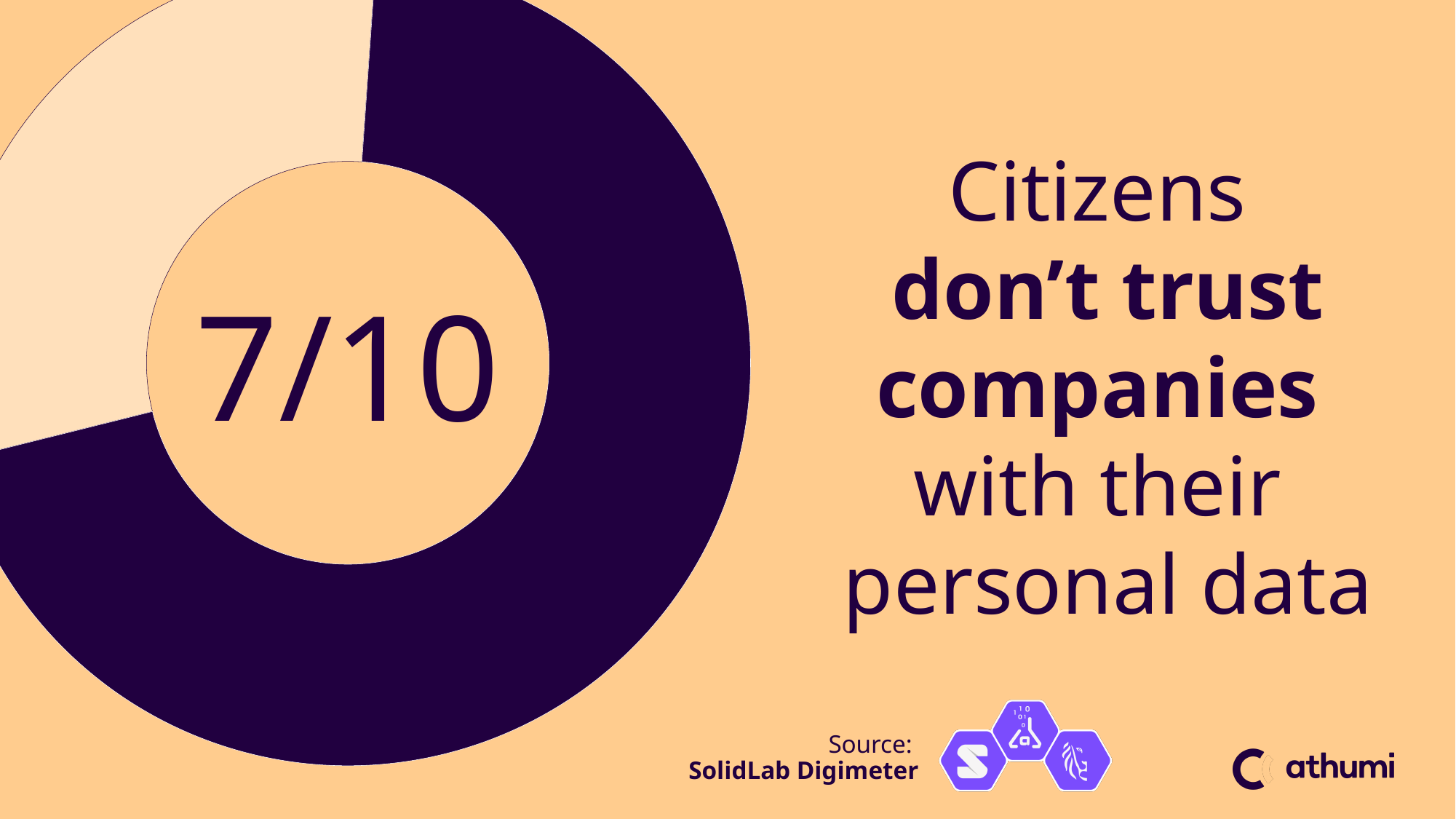
What value is printed in the centre of the donut chart? 7/10 What kind of chart is shown on the slide? Donut (pie) chart What source is cited for the chart on the slide? SolidLab Digimeter What statement does the slide make about the 7/10 figure? Citizens don't trust companies with their personal data Which segment of the donut chart is larger, the dark purple one or the light one? The dark purple one Is the light segment of the donut chart greater or less than half of the whole? less Is the dark purple segment of the donut chart greater or less than half of the whole? greater What share of the donut does the dark purple segment represent, according to the label in the centre? 7/10 How many segments does the donut chart have? 2